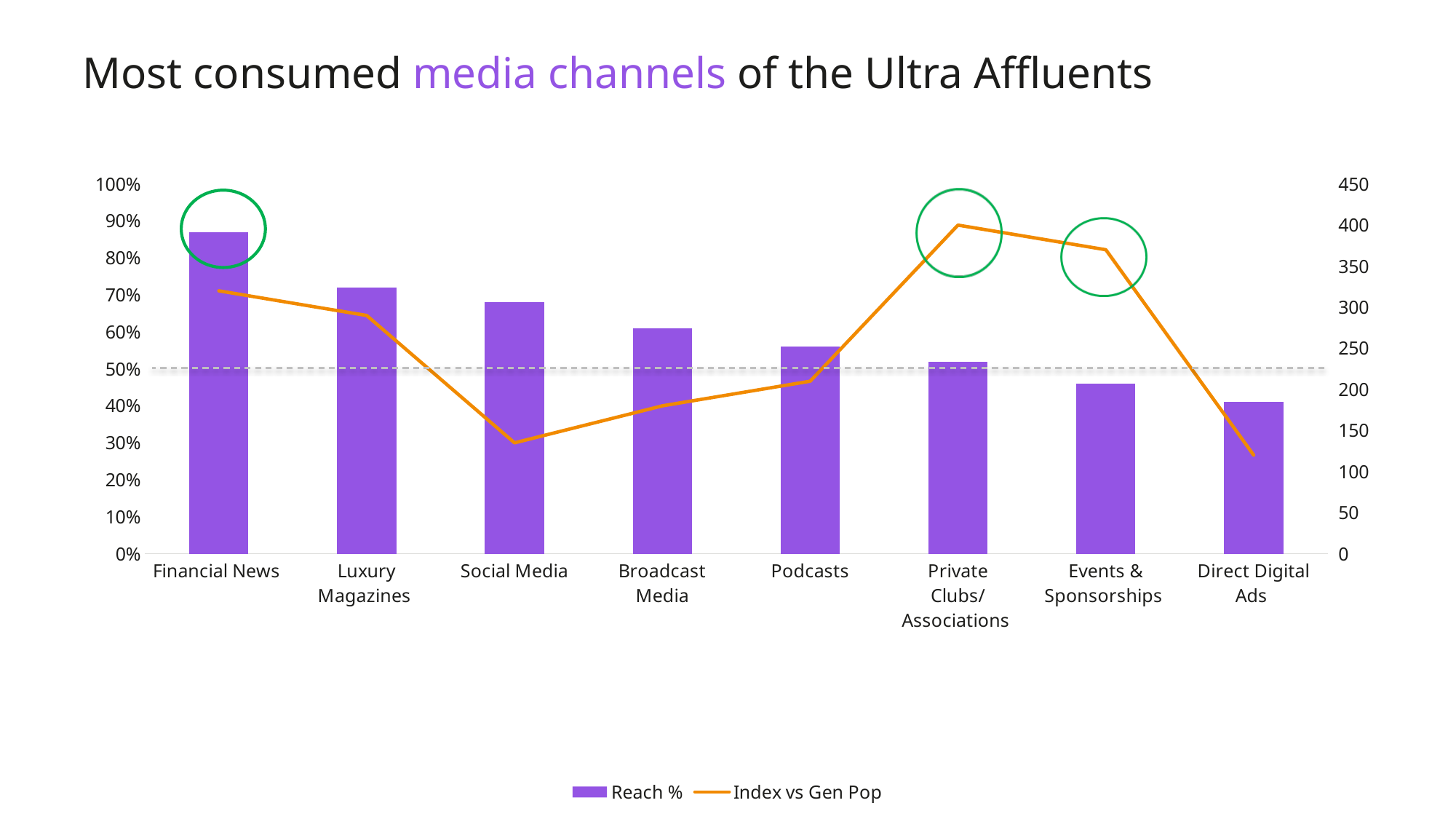
Is the Reach % for Direct Digital Ads greater or less than 50%? less Which media channel has the lowest Reach %? Direct Digital Ads Is the Reach % for Financial News greater or less than 80%? greater Do the Reach % bars rise or fall from left to right across the x axis? fall Which media channel has the highest Reach %? Financial News Which has a higher Reach %, Luxury Magazines or Podcasts? Luxury Magazines Is the Index vs Gen Pop for Private Clubs/Associations greater or less than 350? greater How many series does the legend list? 2 What kind of chart is shown on the slide? A bar chart combined with a line chart Which media channel has the highest Index vs Gen Pop? Private Clubs/Associations How many media channel categories are shown on the x axis? 8